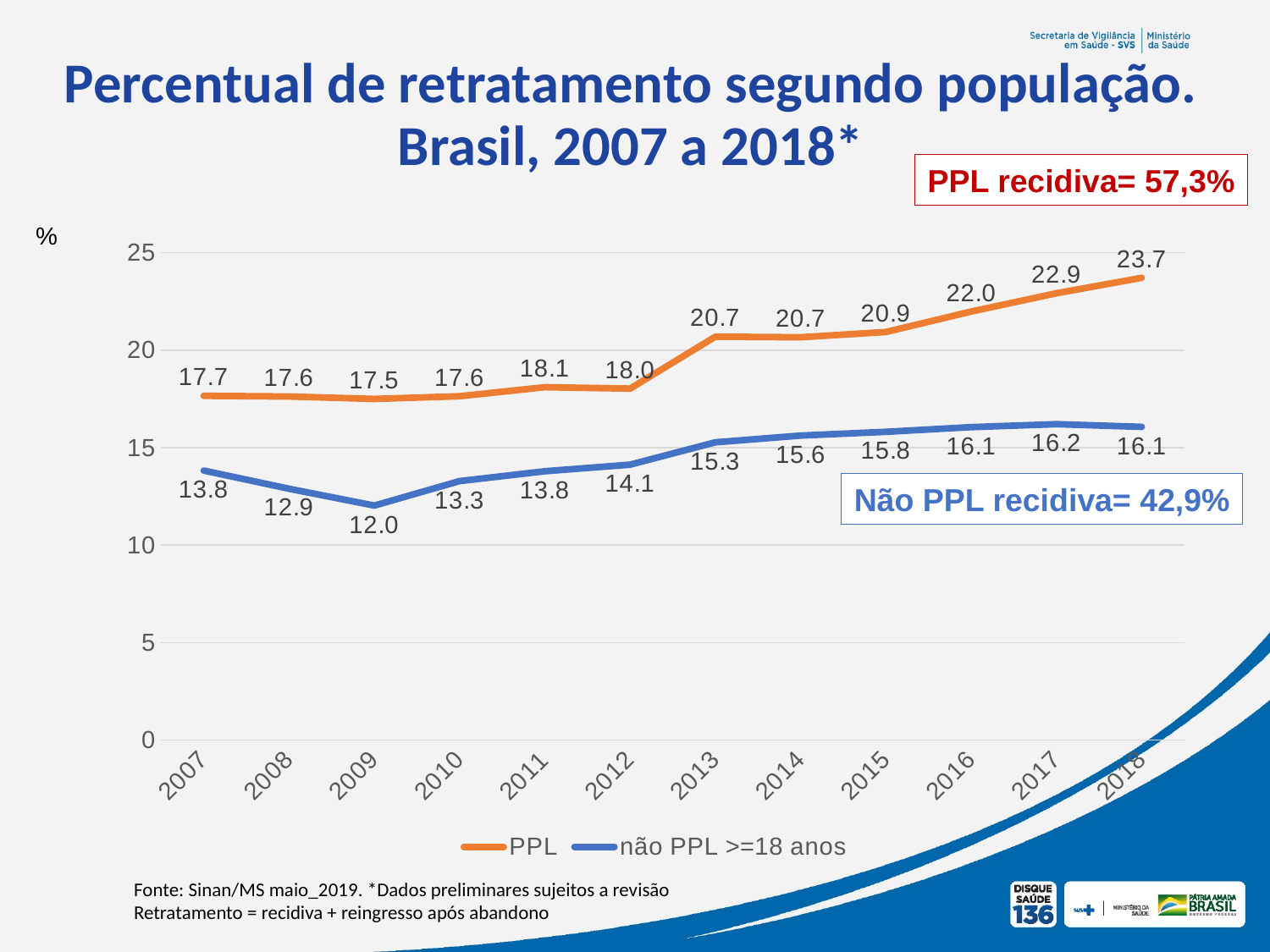
Which series has the larger value in 2012, PPL or não PPL >=18 anos? PPL What is the difference between the PPL and não PPL >=18 anos values in 2018? 7.6 What is the value for PPL in 2013? 20.7 In which year is the PPL series at its highest? 2018 What type of chart is shown on the slide? Line chart Does the PPL series generally rise or fall from 2012 to 2018? Rise In which year is the não PPL >=18 anos series at its lowest? 2009 How many years are shown on the x axis? 12 What colour is the line for the PPL series? Orange How many series does the legend list? 2 What is the value for não PPL >=18 anos in 2009? 12.0 What is the value for PPL in 2018? 23.7